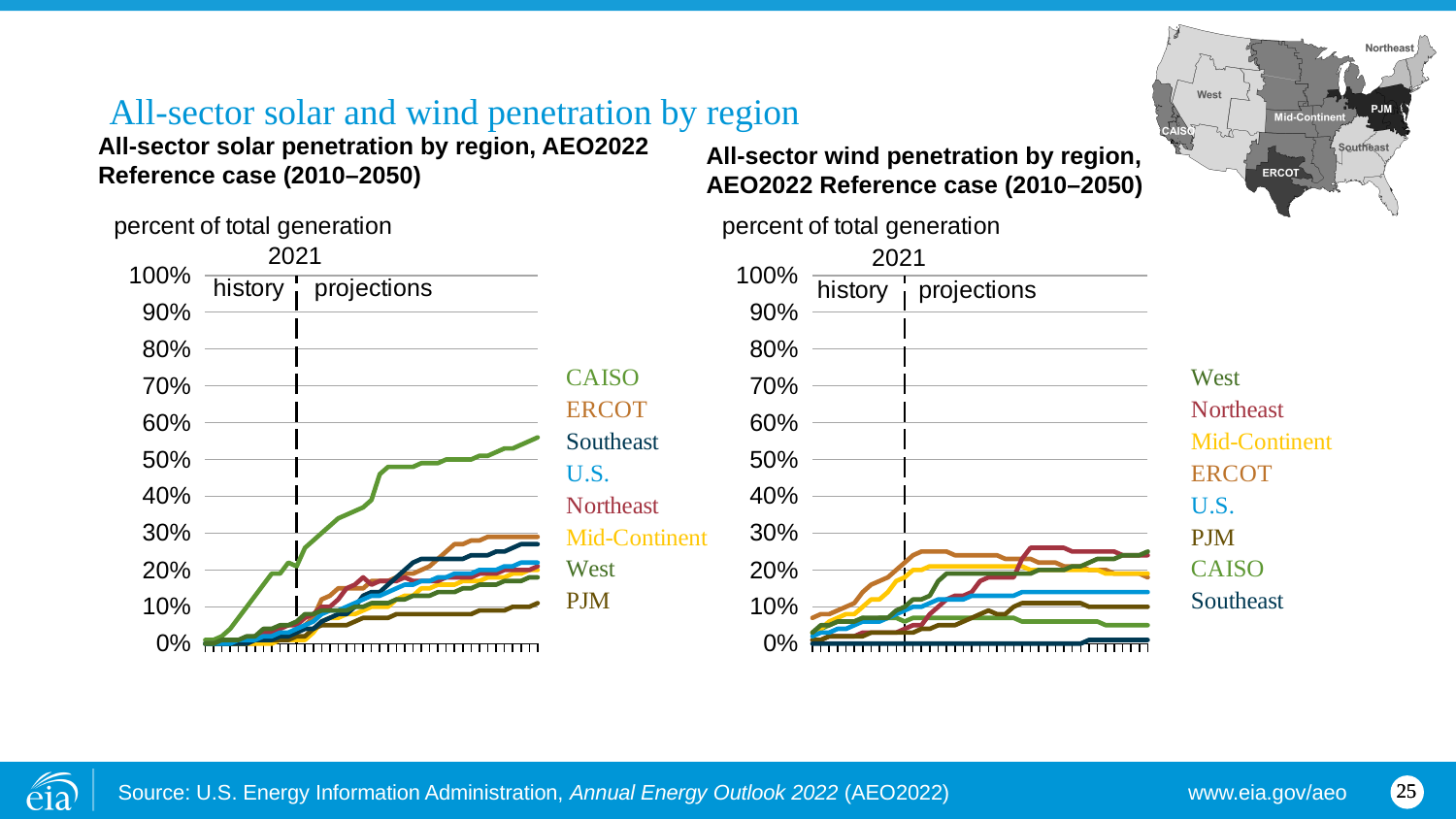
In the 'All-sector solar penetration by region' chart on the left, is the value for PJM in 2050 greater or less than 20%? less In the 'All-sector solar penetration by region' chart on the left, which region has the lowest solar penetration at the end of the projection period? PJM What kind of chart is the 'All-sector solar penetration by region' chart on the left? line chart In the 'All-sector wind penetration by region' chart on the right, which region has the lowest wind penetration at the end of the projection period? Southeast In the 'All-sector solar penetration by region' chart on the left, is the value for CAISO in 2050 greater or less than 50%? greater In the 'All-sector wind penetration by region' chart on the right, is the value for Southeast in 2050 greater or less than 10%? less How many series does the legend of the 'All-sector wind penetration by region' chart on the right list? 8 In the 'All-sector solar penetration by region' chart on the left, does the CAISO line rise or fall from 2010 to 2050? rise In the 'All-sector solar penetration by region' chart on the left, which region has the highest solar penetration at the end of the projection period? CAISO In the 'All-sector wind penetration by region' chart on the right, which region has the highest wind penetration at the end of the projection period? West What year does the dashed vertical line separating history from projections mark in both charts? 2021 In the 'All-sector solar penetration by region' chart on the left, which is larger at the end of the projection period, CAISO or ERCOT? CAISO